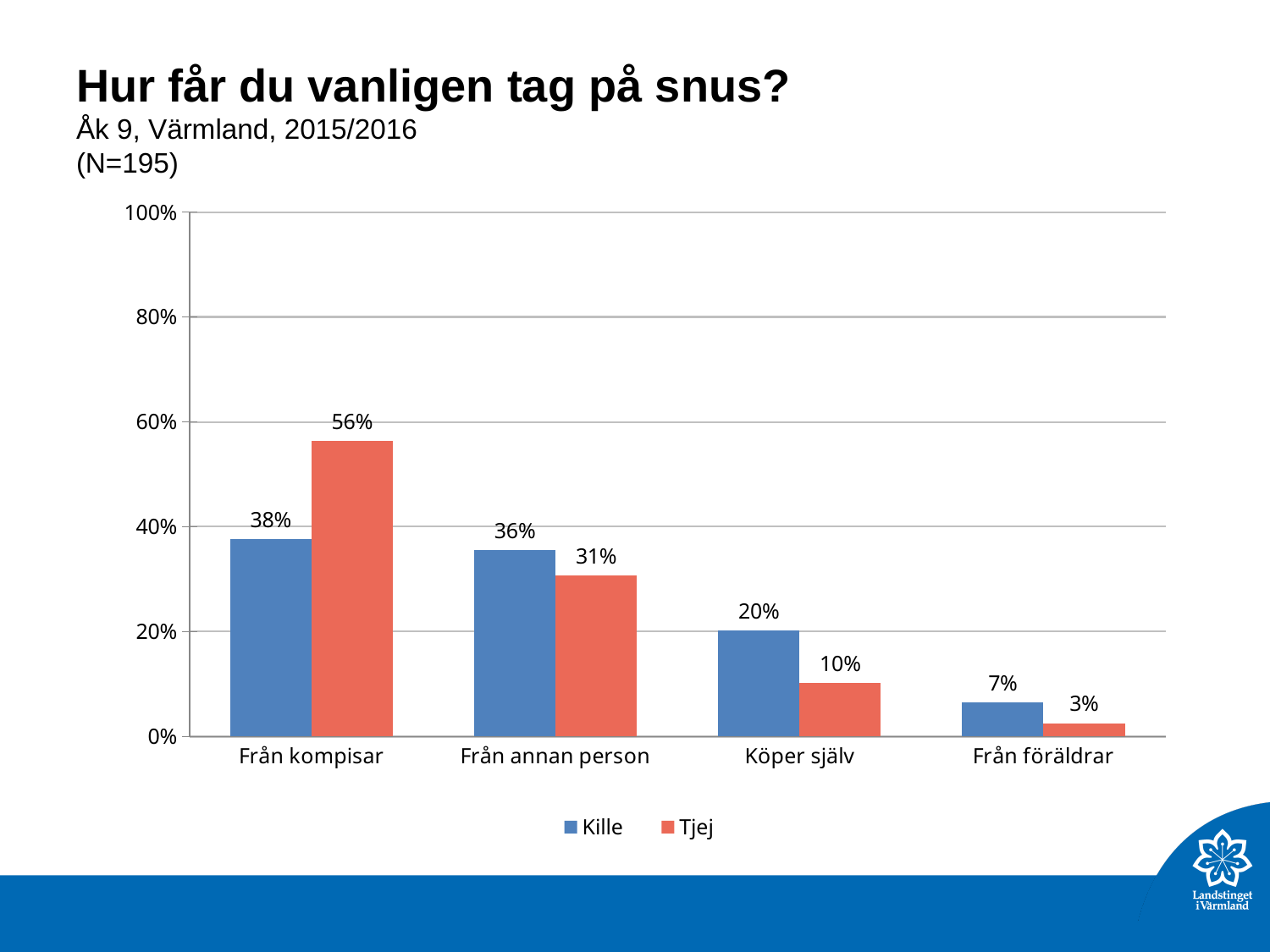
Which is larger for 'Från annan person', the Kille value or the Tjej value? Kille Which category has the highest value for Tjej? Från kompisar What is the difference between the Tjej and Kille values for 'Från kompisar'? 18% Which category has the lowest value for Kille? Från föräldrar What is the difference between the Kille and Tjej values for 'Köper själv'? 10% How many series does the legend list? 2 What is the value for Kille in the 'Från kompisar' category? 38% Which colour represents the Tjej series? Red/orange What kind of chart is shown on the slide? Bar chart How many categories are shown on the x axis? 4 What is the value for Tjej in the 'Köper själv' category? 10% What is the value for Tjej in the 'Från föräldrar' category? 3%